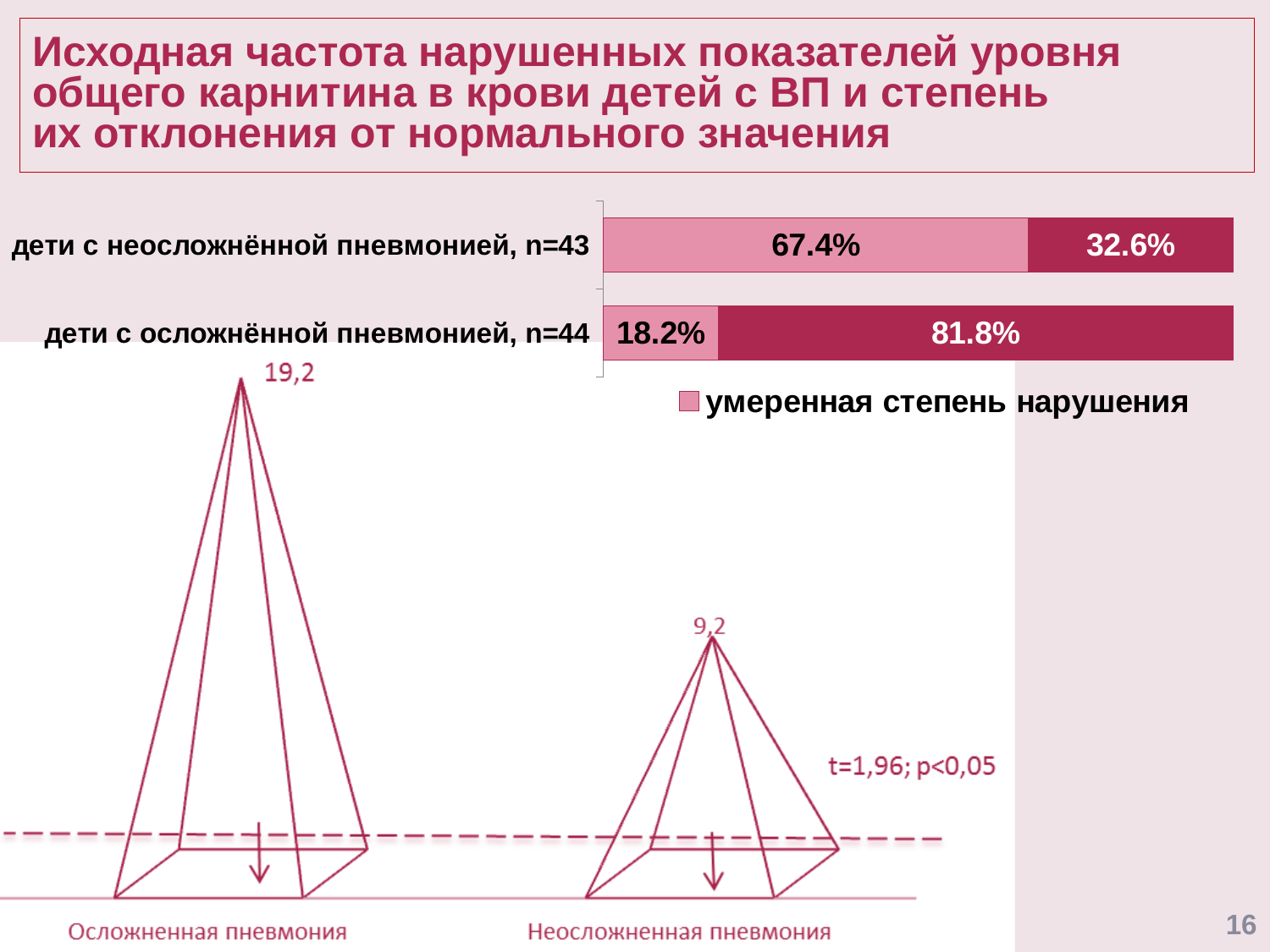
In the stacked bar chart at the top right, what is the difference between the two segments of the bar for дети с осложнённой пневмонией, n=44? 63.6% In the stacked bar chart at the top right, what is the total of the bar for дети с неосложнённой пневмонией, n=43? 100% In the pyramid chart at the bottom, what value is shown for Неосложненная пневмония? 9,2 In the stacked bar chart at the top right, what is the value for 'умеренная степень нарушения' for дети с неосложнённой пневмонией, n=43? 67.4% In the pyramid chart at the bottom, what statistical annotation is printed next to the smaller pyramid? t=1,96; p<0,05 In the pyramid chart at the bottom, what value is shown for Осложненная пневмония? 19,2 In the stacked bar chart at the top right, what is the value for 'умеренная степень нарушения' for дети с осложнённой пневмонией, n=44? 18.2% In the stacked bar chart at the top right, what is the value of the darker segment for дети с осложнённой пневмонией, n=44? 81.8% What kind of chart is shown at the top right of the slide? Stacked bar chart In the stacked bar chart at the top right, which group has the higher value for 'умеренная степень нарушения'? дети с неосложнённой пневмонией, n=43 In the stacked bar chart at the top right, what is the value of the darker segment for дети с неосложнённой пневмонией, n=43? 32.6% In the stacked bar chart at the top right, how many categories (bars) are shown? 2